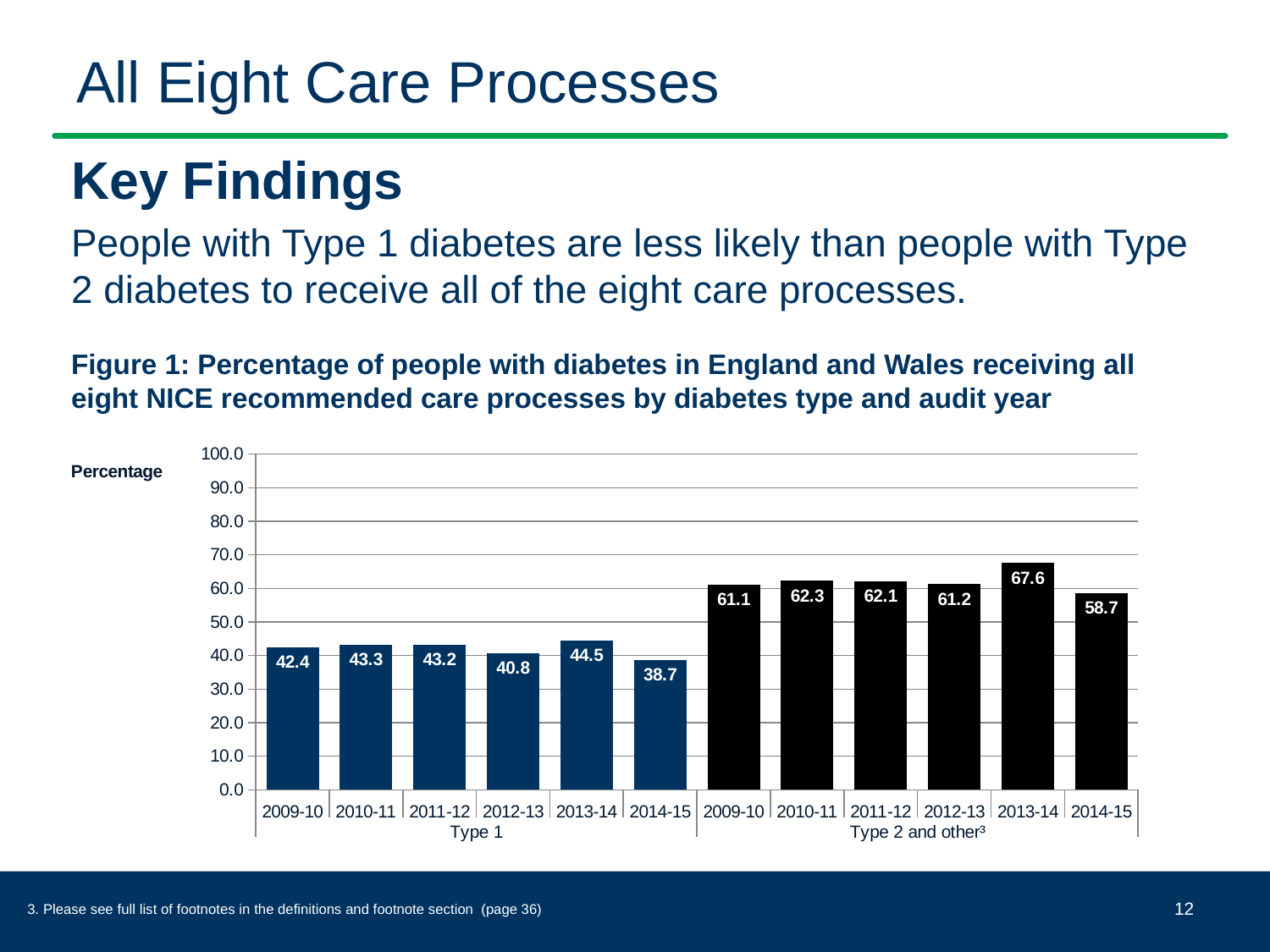
Which is larger in 2012-13: the Type 1 value or the Type 2 and other value? Type 2 and other What is the value for Type 1 in 2009-10? 42.4 How many bars are plotted in the chart? 12 What is the value for Type 2 and other in 2013-14? 67.6 What is the label on the vertical axis of the chart? Percentage What is the difference between the Type 2 and other value and the Type 1 value in 2013-14? 23.1 What is the value for Type 1 in 2014-15? 38.7 Which audit year has the lowest value for Type 1? 2014-15 What kind of chart is shown? Bar chart Does the Type 1 value rise or fall from 2013-14 to 2014-15? Fall Is the value for Type 2 and other in 2014-15 greater or less than 50.0? greater Which audit year has the highest value for Type 2 and other? 2013-14